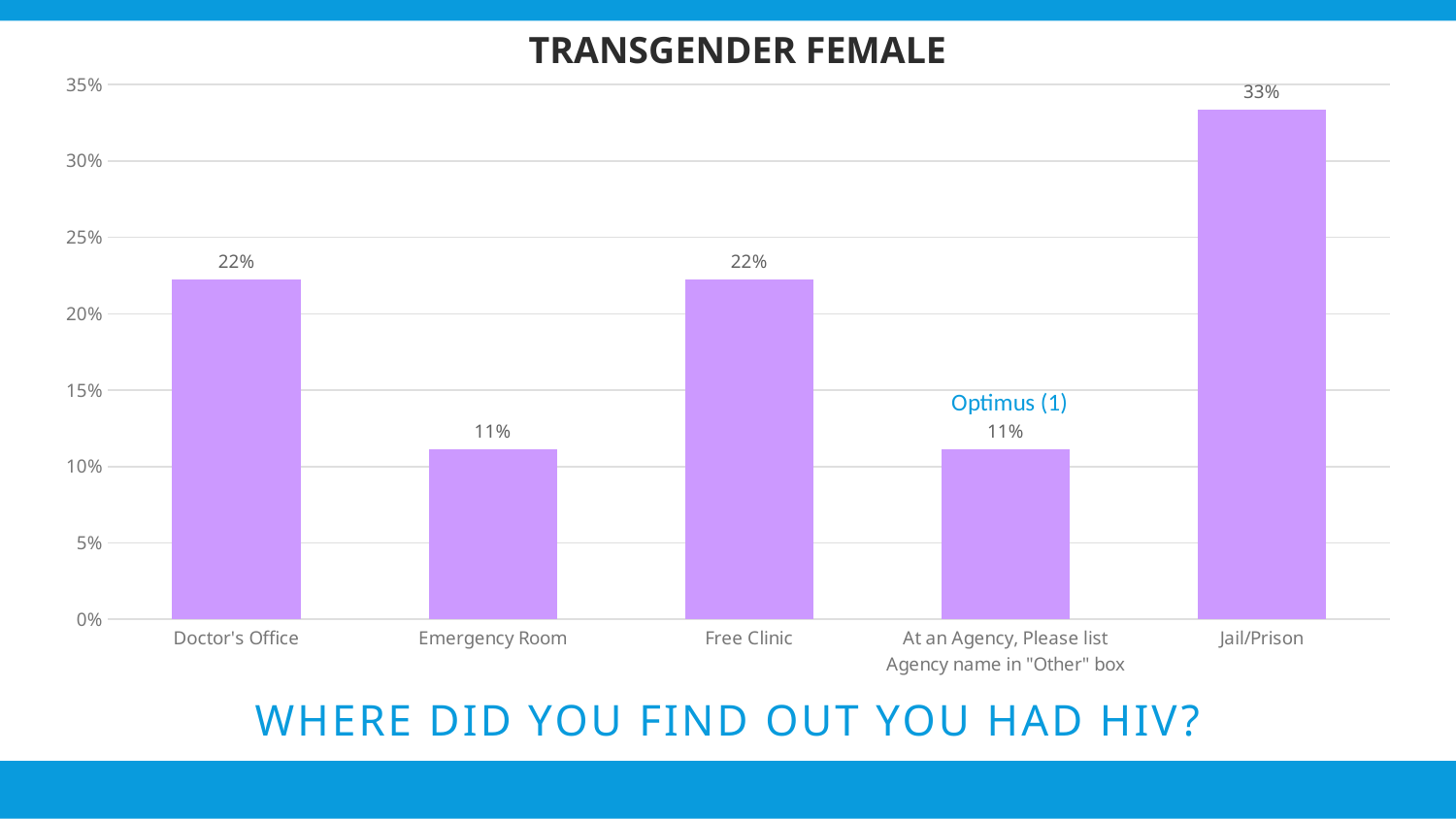
Which is larger, the value for Doctor's Office or the value for Emergency Room? Doctor's Office What is the difference between the values for Jail/Prison and Doctor's Office? 11% What is the difference between the values for Free Clinic and Emergency Room? 11% What is the value for Free Clinic? 22% Which category has the highest value? Jail/Prison What is the value for Emergency Room? 11% What kind of chart is shown on the slide? Bar chart What agency name is annotated above the bar for 'At an Agency, Please list Agency name in "Other" box'? Optimus (1) Is the value for Jail/Prison greater or less than 30%? greater How many categories are shown on the x axis? 5 What is the value for Jail/Prison? 33% What is the title of the chart? TRANSGENDER FEMALE